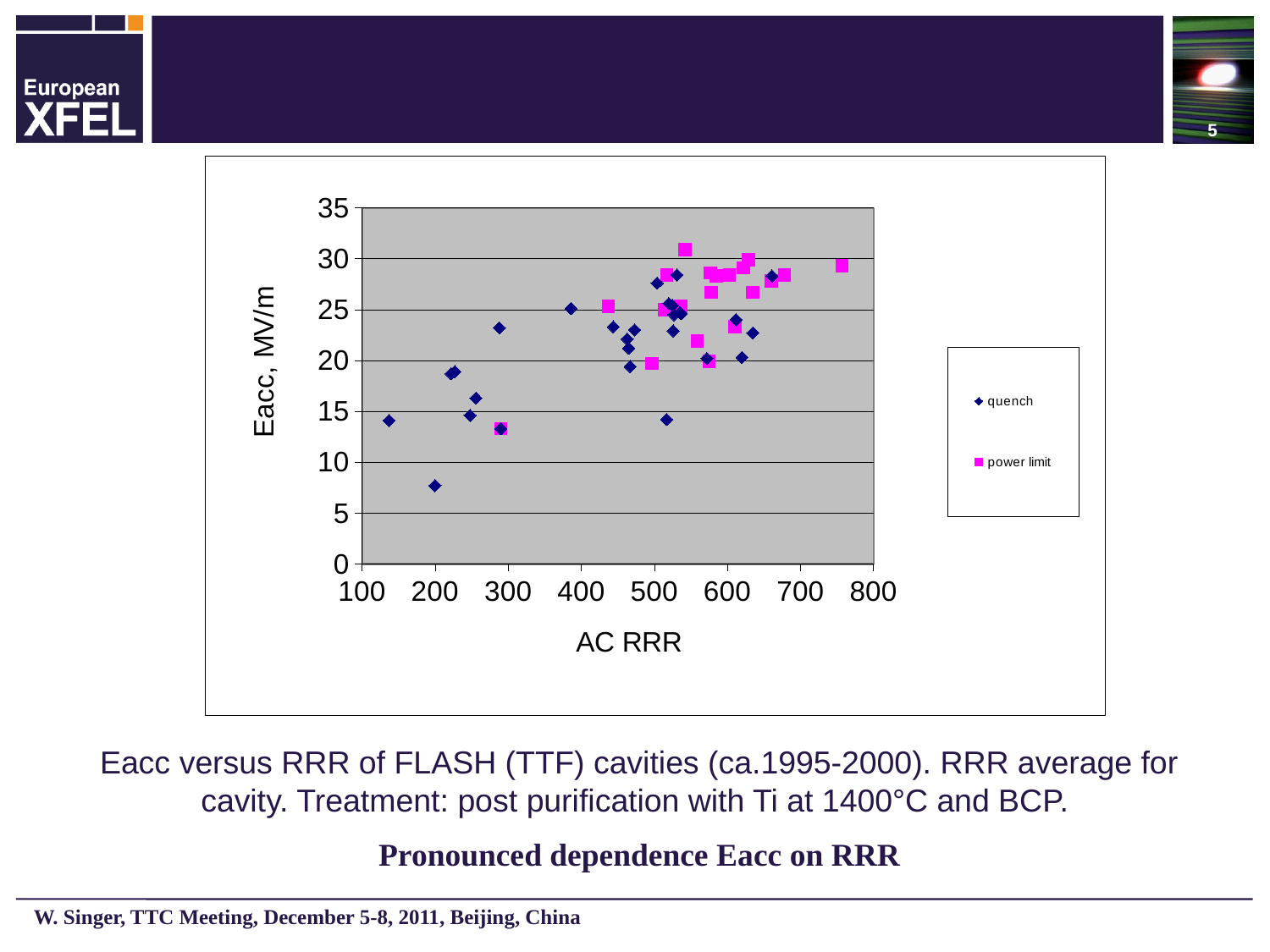
Which series contains the highest plotted Eacc value, quench or power limit? power limit Do the Eacc values generally rise or fall as AC RRR increases? rise Is the lowest power limit value greater or less than 10? greater What is the title of the x axis? AC RRR What kind of chart is shown on the slide? scatter chart How many series does the legend list? 2 Is the highest power limit value greater or less than 25? greater Is the lowest quench value greater or less than 10? less What are the two series named in the legend? quench and power limit Which series contains the lowest plotted Eacc value, quench or power limit? quench